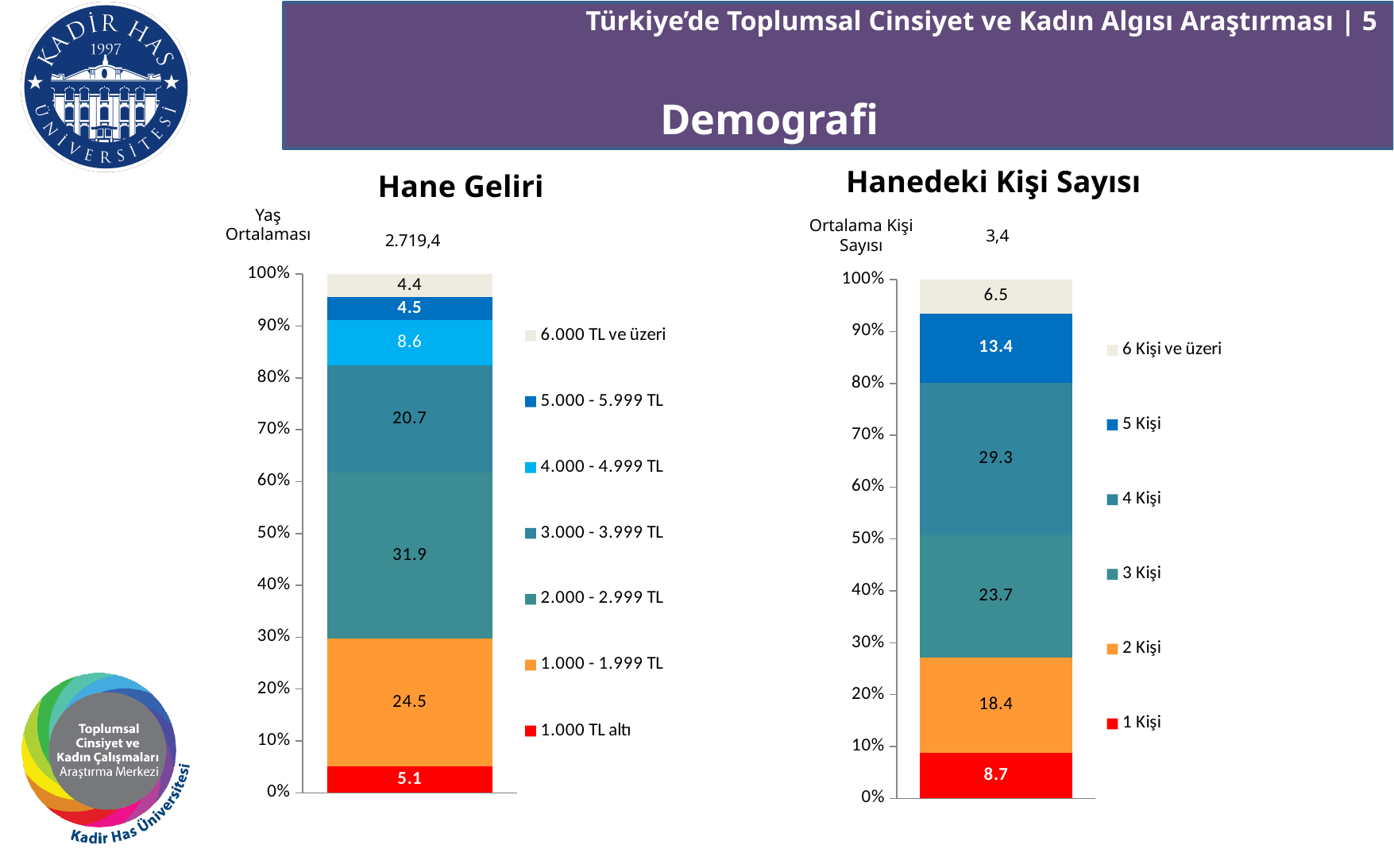
What kind of chart is the Hanedeki Kişi Sayısı chart? Stacked bar chart In the Hanedeki Kişi Sayısı chart, what is the difference between the 3 Kişi and 2 Kişi values? 5.3 In the Hanedeki Kişi Sayısı chart, which household size has the smallest value? 6 Kişi ve üzeri In the Hane Geliri chart, what is the difference between the 1.000 - 1.999 TL segment and the 3.000 - 3.999 TL segment? 3.8 In the Hanedeki Kişi Sayısı chart, what is the value for 1 Kişi? 8.7 In the Hane Geliri chart, what average value is printed above the bar? 2.719,4 In the Hanedeki Kişi Sayısı chart, which is larger, the value for 2 Kişi or the value for 5 Kişi? 2 Kişi In the Hanedeki Kişi Sayısı chart, what is the value for 4 Kişi? 29.3 In the Hane Geliri chart, what is the value for the 1.000 TL altı segment? 5.1 In the Hane Geliri chart, what is the value for the 2.000 - 2.999 TL segment? 31.9 In the Hane Geliri chart, which income segment has the largest value? 2.000 - 2.999 TL In the Hane Geliri chart, how many series does the legend list? 7